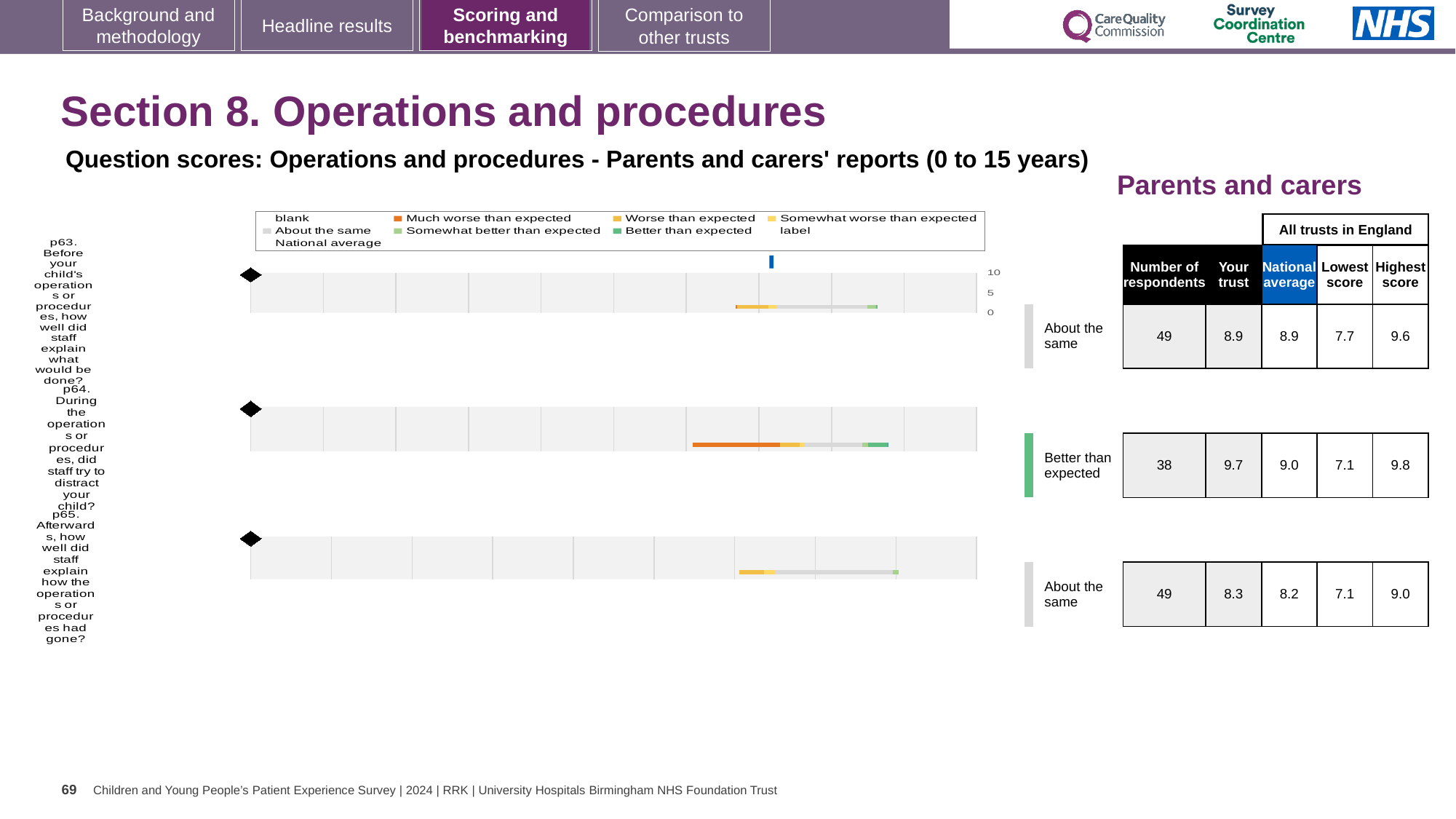
What is the national average score for p63 (Before your child's operations or procedures, how well did staff explain what would be done?)? 8.9 For p65, which is larger: the 'Your trust' score or the national average? Your trust What is the 'Your trust' score for p64 (During the operations or procedures, did staff try to distract your child?)? 9.7 How many respondents answered p65 (Afterwards, how well did staff explain how the operations or procedures had gone?)? 49 How many questions (p63, p64, p65) are plotted on the slide? 3 What kind of chart is used to show the question scores for p63, p64 and p65? bar chart Which question has the highest 'Your trust' score? p64 For p64, how much higher is the 'Your trust' score than the national average? 0.7 What is the highest score among all trusts in England for p64? 9.8 What colour does the legend use for 'Better than expected'? green Which question has the lowest 'Your trust' score? p65 What benchmark category is shown for p64? Better than expected